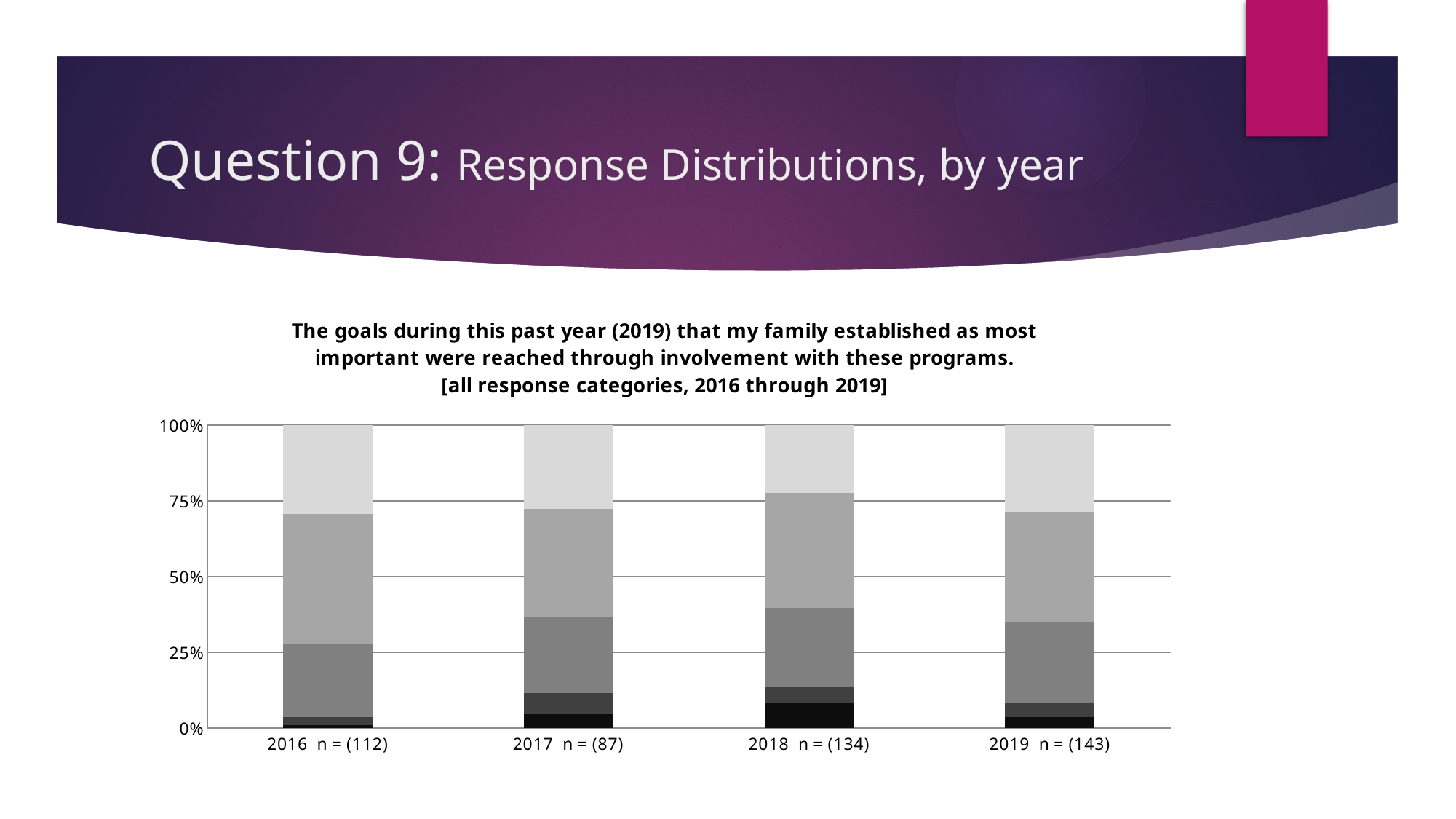
In the 2018 bar, is the boundary between the top (lightest) segment and the segment below it greater or less than 75%? greater What is the sample size (n) shown for 2019? 143 Which year's bar has the smallest lightest (top) segment? 2018 Which year's bar has the largest darkest (bottom) segment? 2018 How many years (bars) are shown on the x axis of the chart? 4 What is the highest value shown on the chart's vertical axis? 100% What is the sample size (n) shown for 2017? 87 What is the difference between the sample sizes for 2019 and 2017? 56 Which year has the smallest sample size (n)? 2017 What kind of chart is shown on the slide? Stacked bar chart How many stacked segments make up each bar in the chart? 5 Which year has the largest sample size (n)? 2019